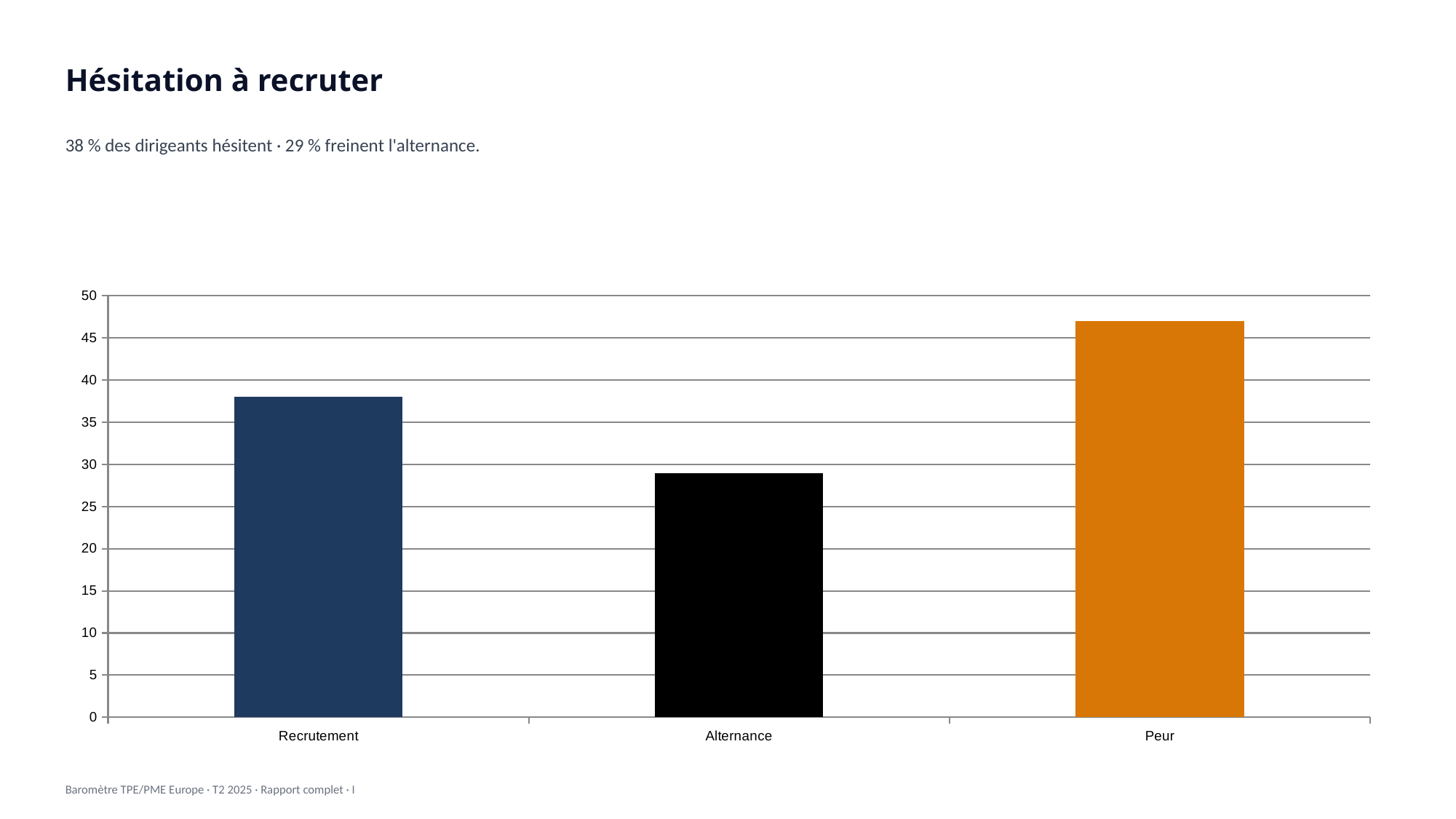
Which category has the highest bar? Peur Which is larger, the value for Peur or the value for Recrutement? Peur What colour is the bar for Peur? orange Is the value for Alternance greater or less than 25? greater What kind of chart is shown on the slide? bar chart Is the value for Recrutement greater or less than 35? greater Which category has the lowest bar? Alternance Is the value for Recrutement greater or less than 40? less What is the title of the slide containing the chart? Hésitation à recruter How many categories are shown on the x axis of the chart? 3 Which is larger, the value for Recrutement or the value for Alternance? Recrutement